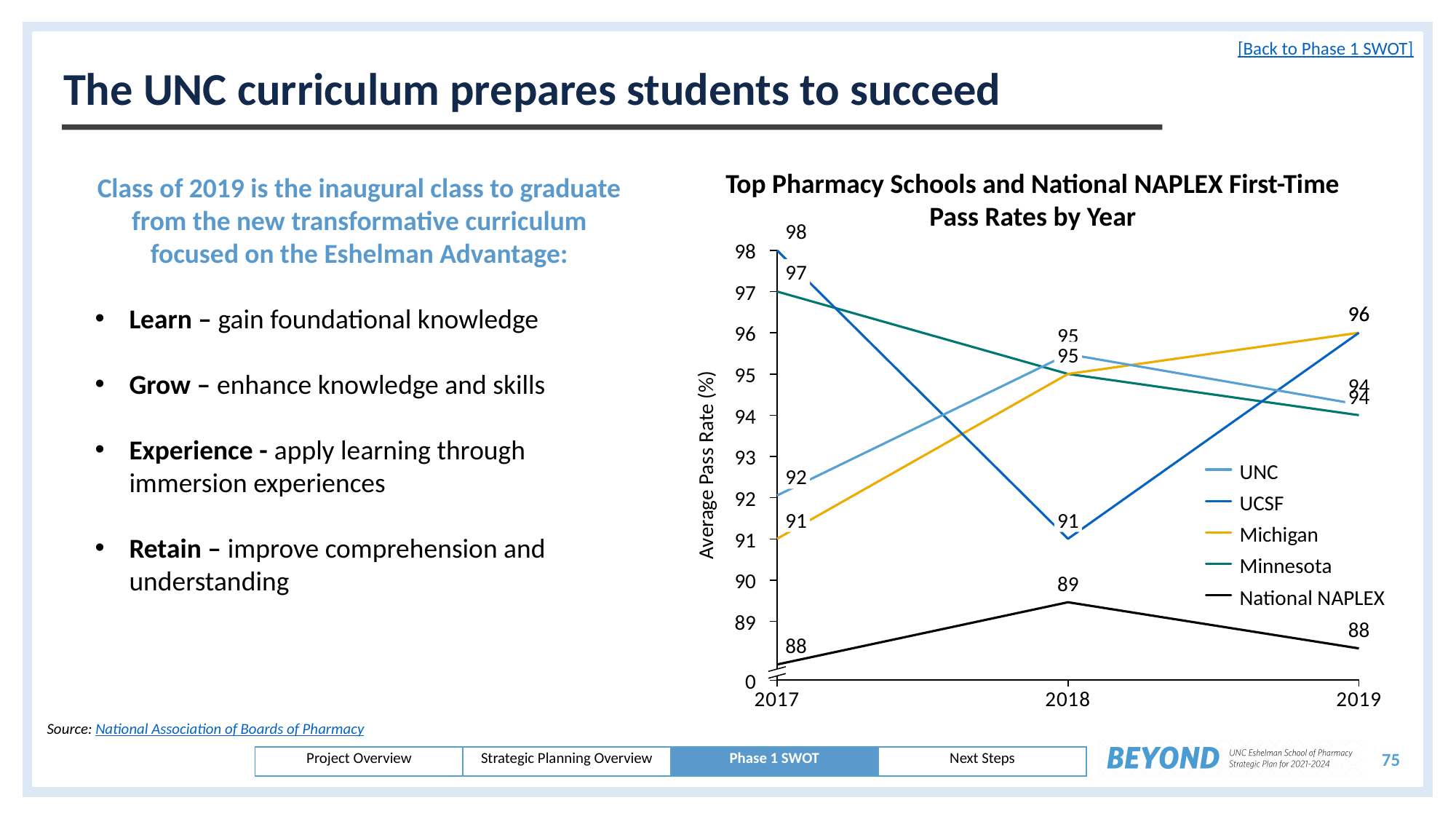
Does Minnesota's pass rate rise or fall from 2017 to 2019? Fall What was UCSF's first-time pass rate in 2017? 98 How many series does the legend of the chart list? 5 What type of chart is shown on the slide? Line chart Which series has the lowest value in every year shown? National NAPLEX What was UNC's first-time pass rate in 2017? 92 What was Minnesota's first-time pass rate in 2017? 97 By how many points did UCSF's pass rate fall from 2017 to 2018? 7 Which school had the highest first-time pass rate in 2017? UCSF How many years are plotted on the x axis of the chart? 3 What was the National NAPLEX first-time pass rate in 2018? 89 What is the label of the y axis of the chart? Average Pass Rate (%)